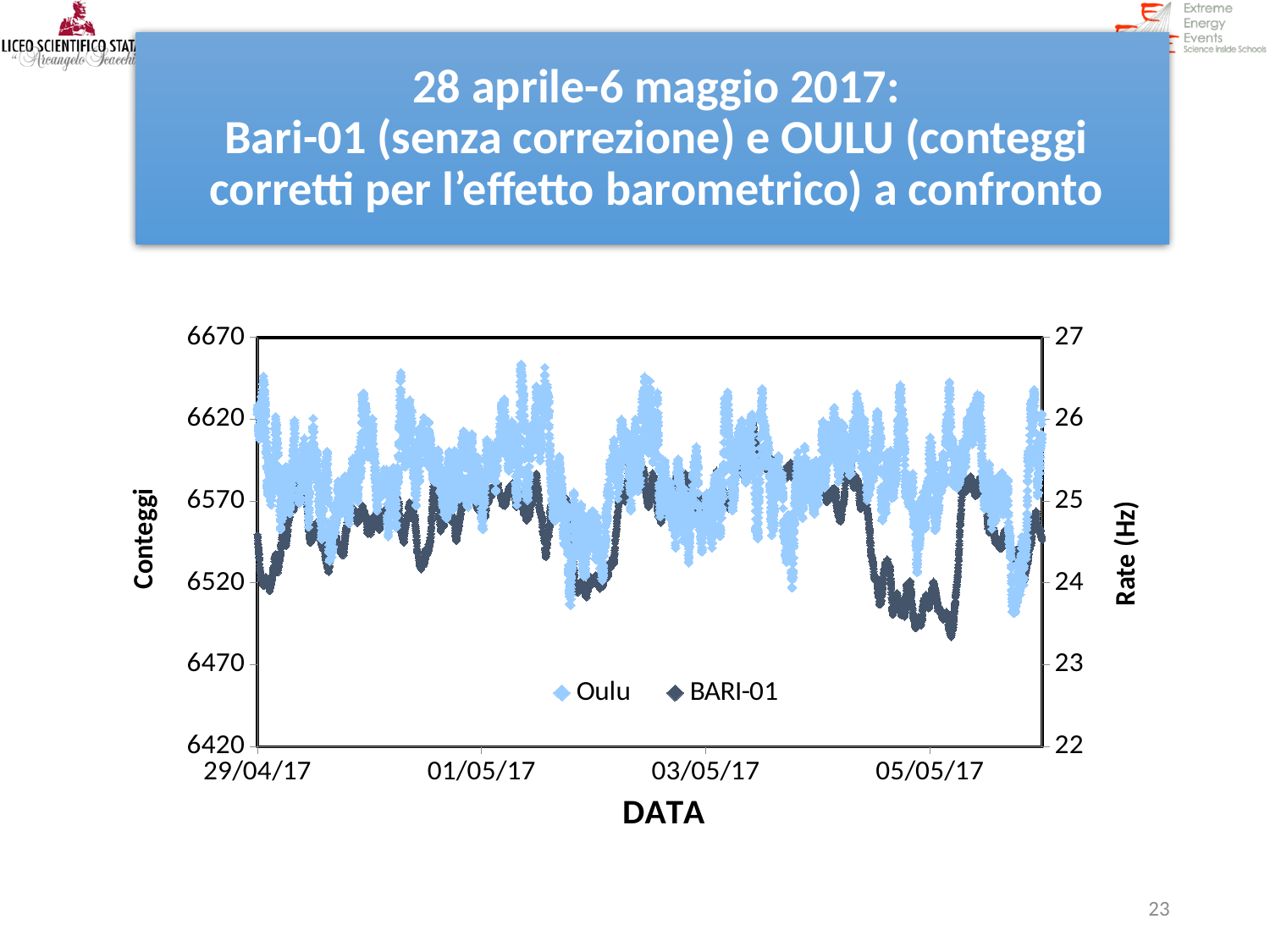
What is the highest value shown on the left y axis (Conteggi)? 6670 How many series does the chart legend list? 2 What kind of chart is shown on the slide? scatter chart What is the lowest value shown on the right y axis (Rate (Hz))? 22 What is the title of the left y axis of the chart? Conteggi What is the title of the x axis of the chart? DATA What is the title of the right y axis of the chart? Rate (Hz) Are all the BARI-01 rate values greater or less than 26 Hz on the right axis? less What are the names of the two series shown in the chart legend? Oulu and BARI-01 What is the first date label shown on the x axis? 29/04/17 Is the lowest BARI-01 rate, reached shortly after 05/05/17, greater or less than 24 Hz on the right axis? less How many date labels are shown on the x axis of the chart? 4